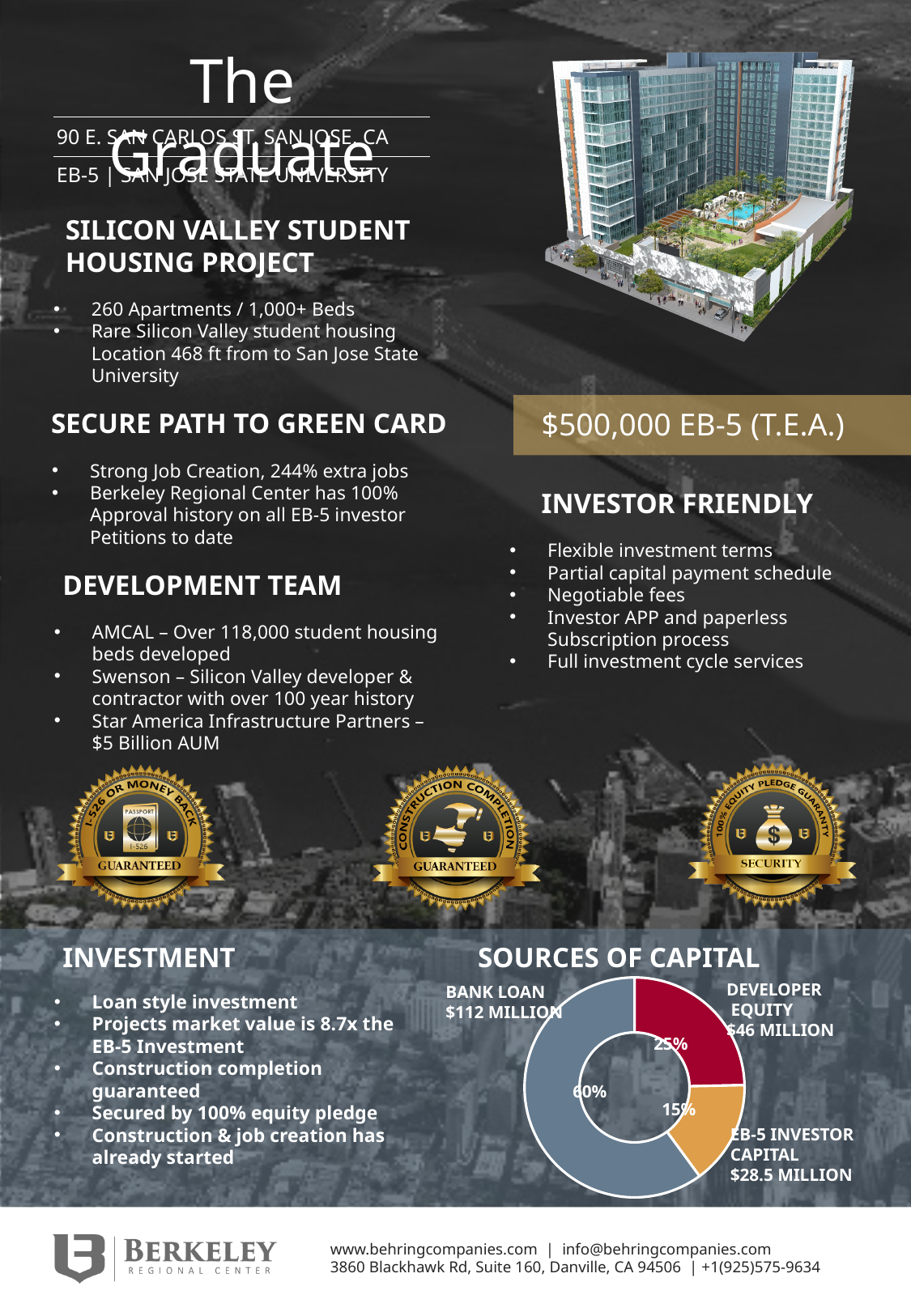
How many slices does the Sources of Capital chart have? 3 Which source of capital is the largest in the chart? Bank Loan In the Sources of Capital chart, which is larger: Developer Equity or EB-5 Investor Capital? Developer Equity What is the dollar amount of the Bank Loan in the Sources of Capital chart? $112 million What is the dollar amount of EB-5 Investor Capital in the Sources of Capital chart? $28.5 million What share of the Sources of Capital chart is Developer Equity? 25% What is the dollar amount of Developer Equity in the Sources of Capital chart? $46 million Which source of capital is the smallest in the chart? EB-5 Investor Capital What share of the Sources of Capital chart is EB-5 Investor Capital? 15% What share of the Sources of Capital chart is the Bank Loan? 60% What kind of chart is shown under "Sources of Capital"? Donut (pie) chart In the Sources of Capital chart, what is the difference in percentage points between the Bank Loan share and the Developer Equity share? 35 percentage points